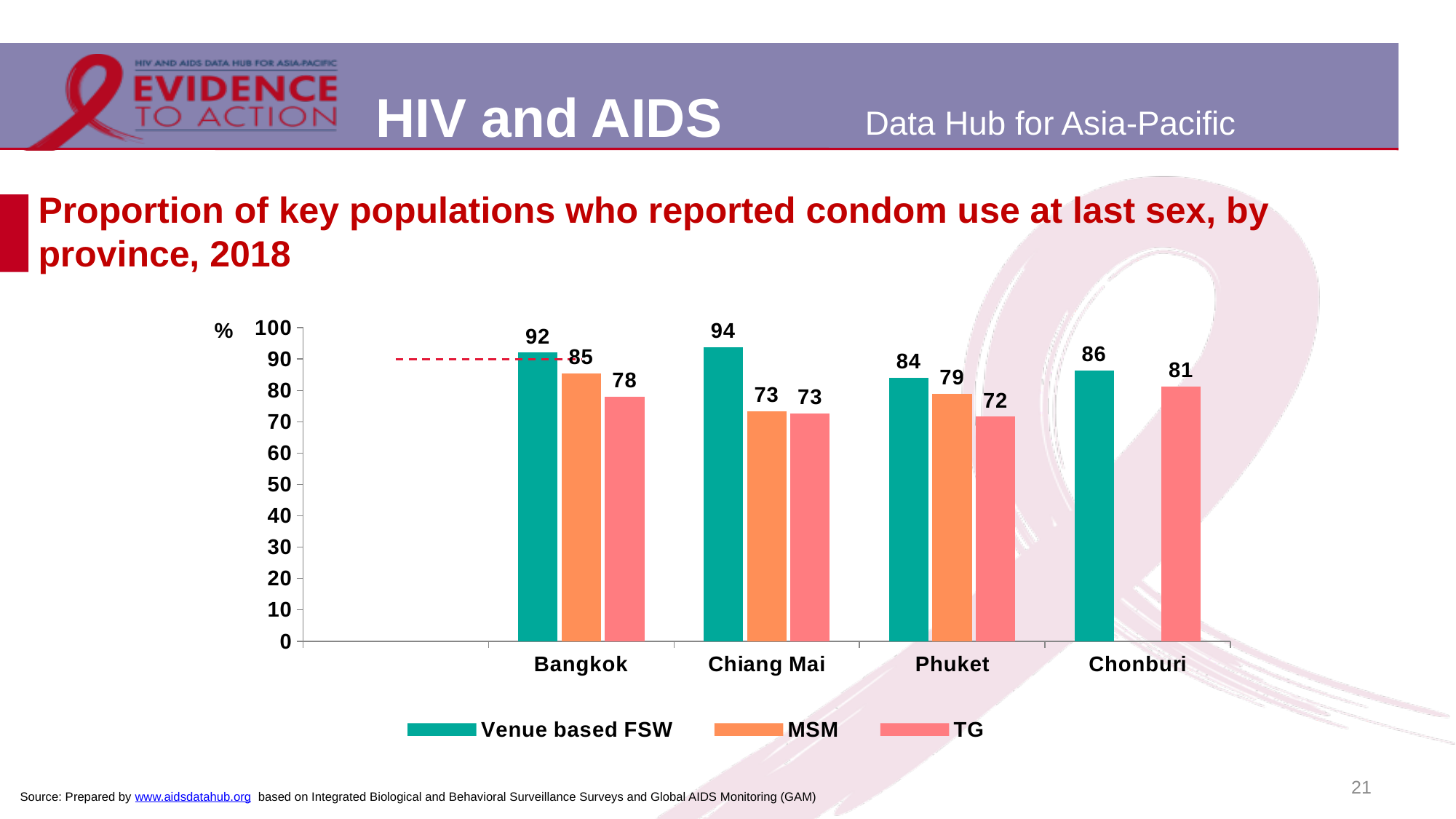
What is the value for Venue based FSW in Bangkok? 92 What is the value for TG in Chonburi? 81 How many provinces are shown on the x axis? 4 What kind of chart is shown on the slide? Bar chart How many series does the legend list? 3 What is the value for TG in Phuket? 72 Which province has the lowest value for TG? Phuket What is the value for MSM in Chiang Mai? 73 What is the difference between the Venue based FSW value and the MSM value in Bangkok? 7 Which is larger in Phuket: the MSM value or the TG value? MSM Which province has no MSM bar plotted? Chonburi Which province has the highest value for Venue based FSW? Chiang Mai